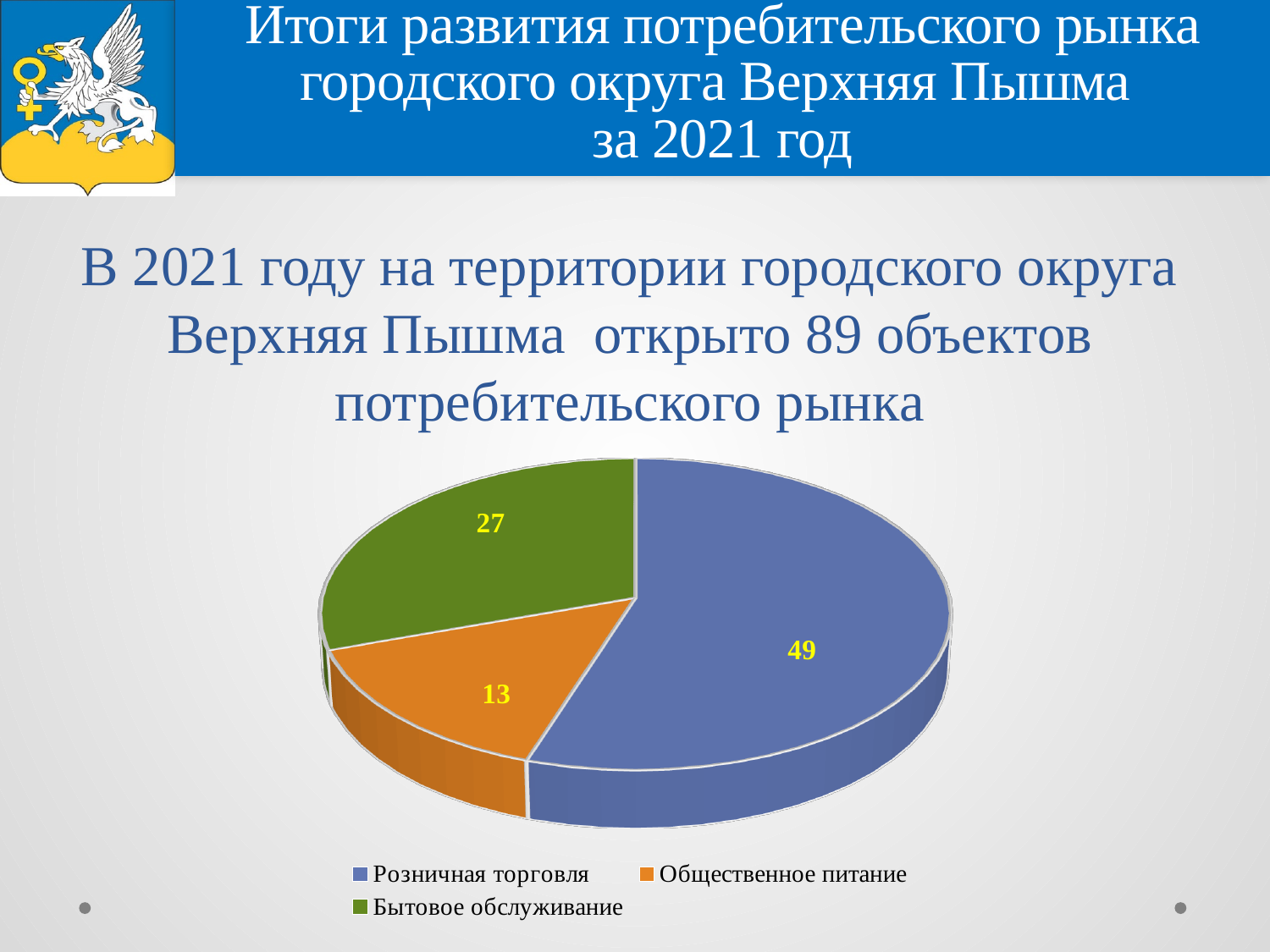
What type of chart is shown on the slide? pie chart What colour is the slice for Общественное питание? orange Which category has the largest slice of the pie? Розничная торговля What is the value for Общественное питание? 13 How many slices does the pie chart have? 3 What is the value for Розничная торговля? 49 What is the value for Бытовое обслуживание? 27 What is the difference between the values for Бытовое обслуживание and Общественное питание? 14 What is the total of all the slices in the pie chart? 89 What is the difference between the values for Розничная торговля and Бытовое обслуживание? 22 Which category has the smallest slice of the pie? Общественное питание Which is larger, the value for Бытовое обслуживание or the value for Общественное питание? Бытовое обслуживание